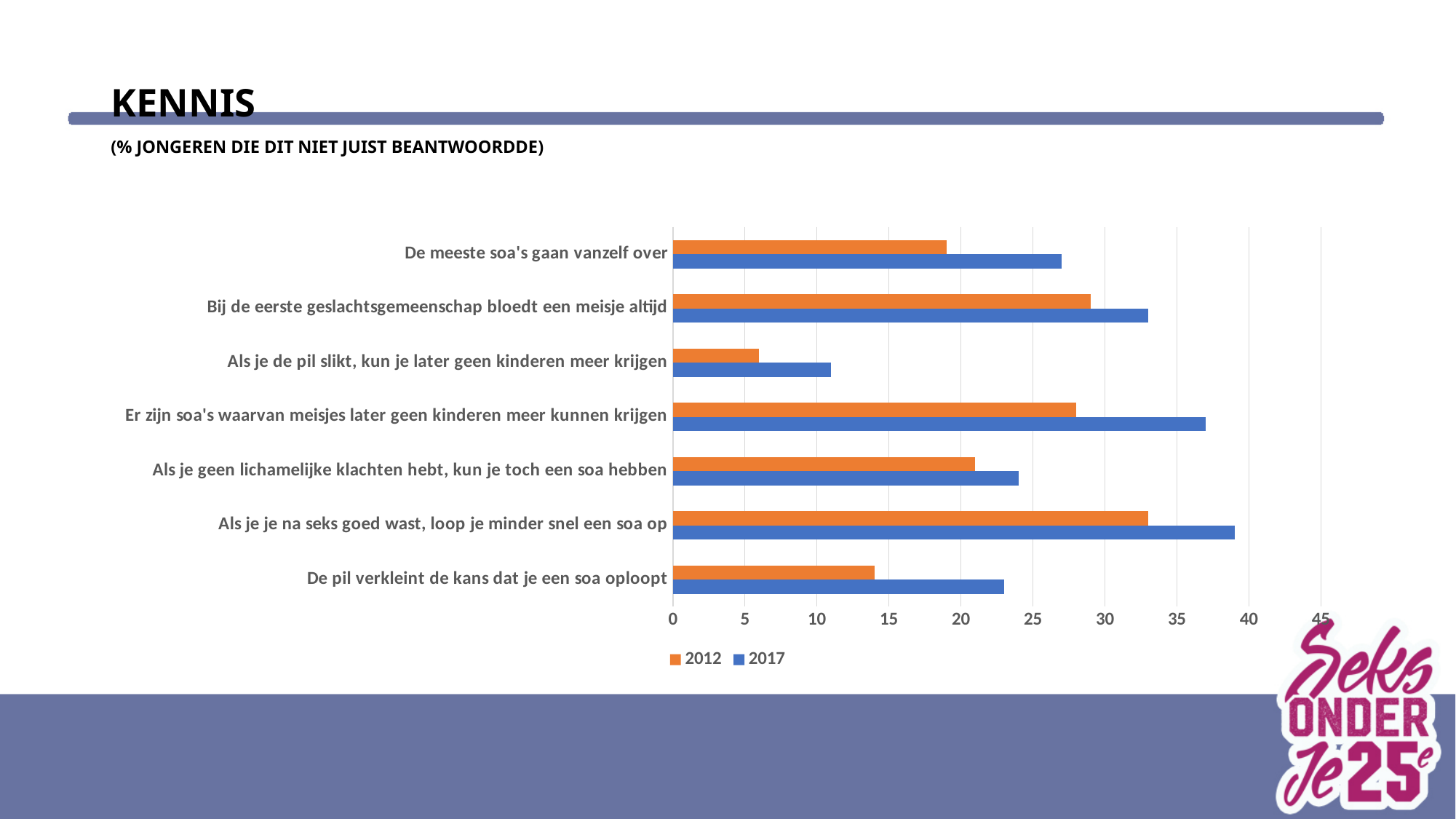
For 'De pil verkleint de kans dat je een soa oploopt', which year has the larger value, 2012 or 2017? 2017 Is the 2012 value for 'De pil verkleint de kans dat je een soa oploopt' greater or less than 15? less What kind of chart is shown on the slide? bar chart Which statement has the lowest value for 2017? Als je de pil slikt, kun je later geen kinderen meer krijgen How many statements (categories) are shown on the chart? 7 Which statement has the lowest value for 2012? Als je de pil slikt, kun je later geen kinderen meer krijgen Which series is shown in orange in the legend? 2012 Which statement has the highest value for 2017? Als je je na seks goed wast, loop je minder snel een soa op How many series does the legend list? 2 Is the 2017 value for 'Er zijn soa's waarvan meisjes later geen kinderen meer kunnen krijgen' greater or less than 35? greater Is the 2012 value for 'Als je de pil slikt, kun je later geen kinderen meer krijgen' greater or less than 10? less What is the title of the chart on the slide? KENNIS